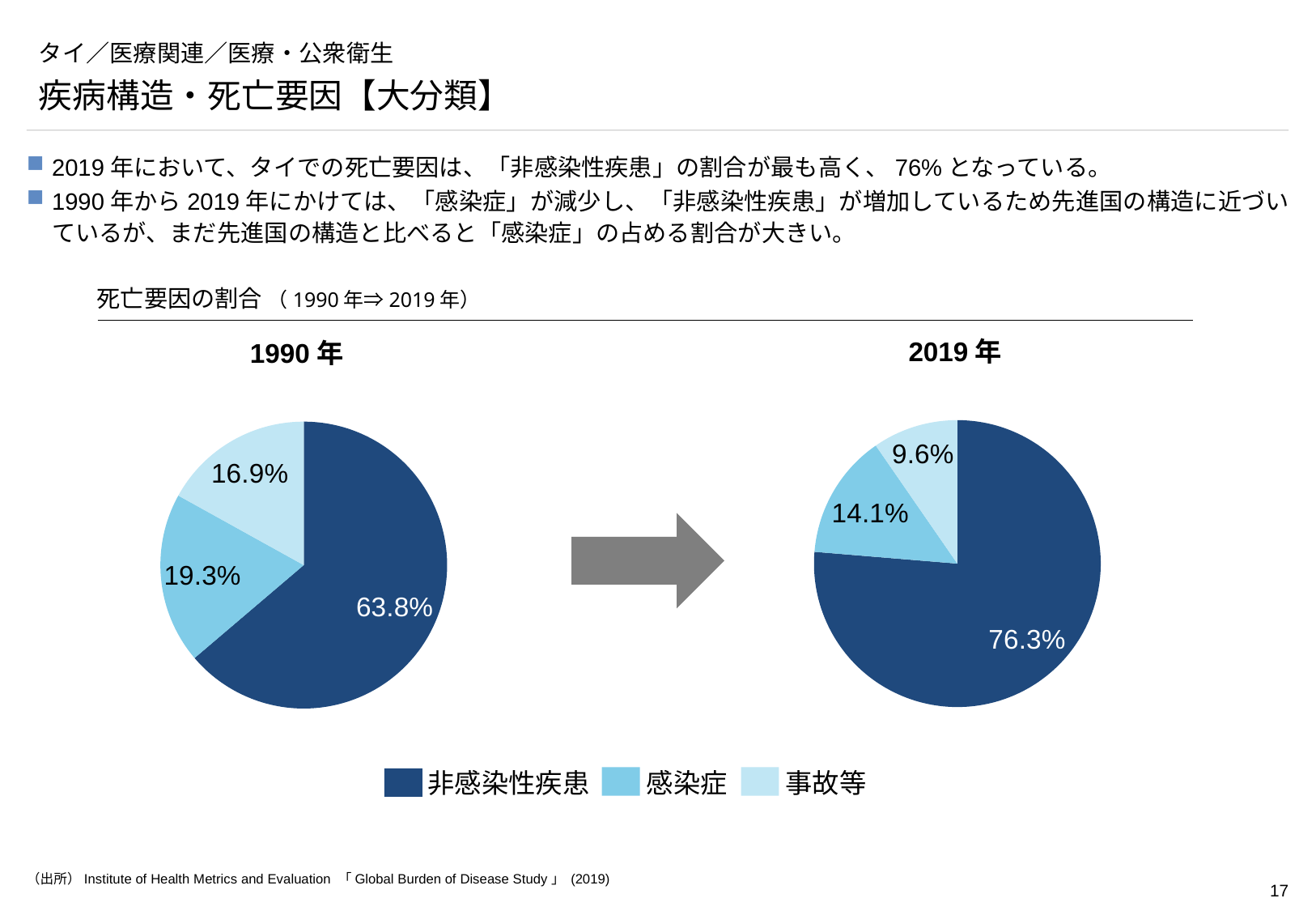
In the 2019年 pie chart, what is the share for 感染症? 14.1% What is the difference between the 非感染性疾患 share in the 2019年 pie chart and in the 1990年 pie chart? 12.5% In the 1990年 pie chart, what is the share for 非感染性疾患? 63.8% In the 1990年 pie chart, what is the share for 事故等? 16.9% In the 1990年 pie chart, which category has the smallest share? 事故等 In the 2019年 pie chart, what is the share for 事故等? 9.6% Which is larger: the 感染症 share in the 1990年 pie chart or in the 2019年 pie chart? 1990年 How many categories does each pie chart show? 3 Which legend entry is shown in the darkest blue colour? 非感染性疾患 In the 1990年 pie chart, what is the difference between the 感染症 share and the 事故等 share? 2.3% What type of chart is used to show the 死亡要因の割合 for 1990年 and 2019年? Pie chart In the 2019年 pie chart, which category has the largest share? 非感染性疾患